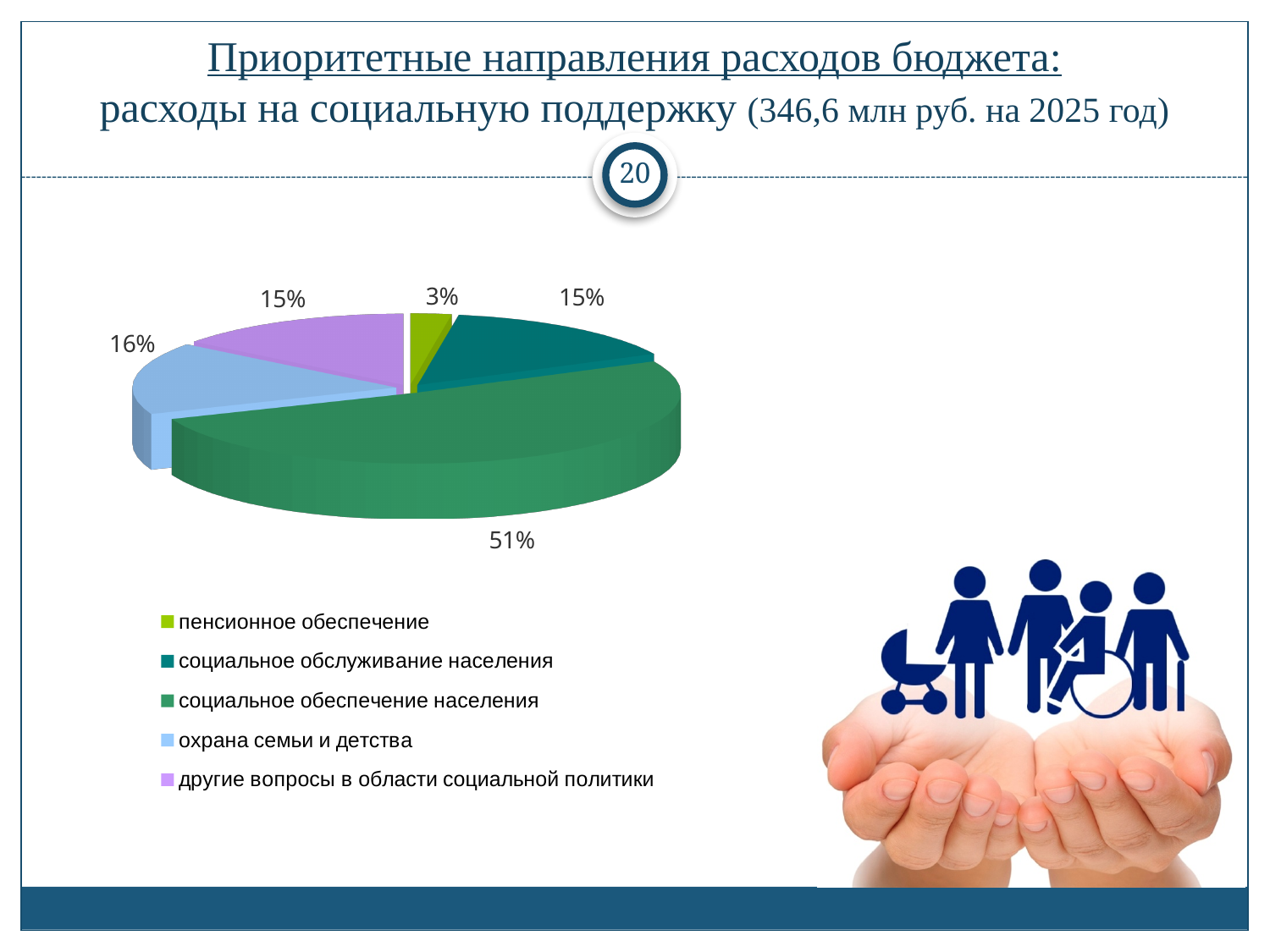
Which category has the smallest slice of the pie? пенсионное обеспечение Which category has the largest slice of the pie? социальное обеспечение населения Which is larger: the share for "охрана семьи и детства" or the share for "пенсионное обеспечение"? охрана семьи и детства What share of the pie does "социальное обслуживание населения" have? 15% What colour is the slice for "социальное обеспечение населения"? green What share of the pie does "охрана семьи и детства" have? 16% What kind of chart is shown on the slide? pie chart What share of the pie does "социальное обеспечение населения" have? 51% How many slices does the pie chart have? 5 What is the difference in percentage points between "социальное обеспечение населения" and "охрана семьи и детства"? 35